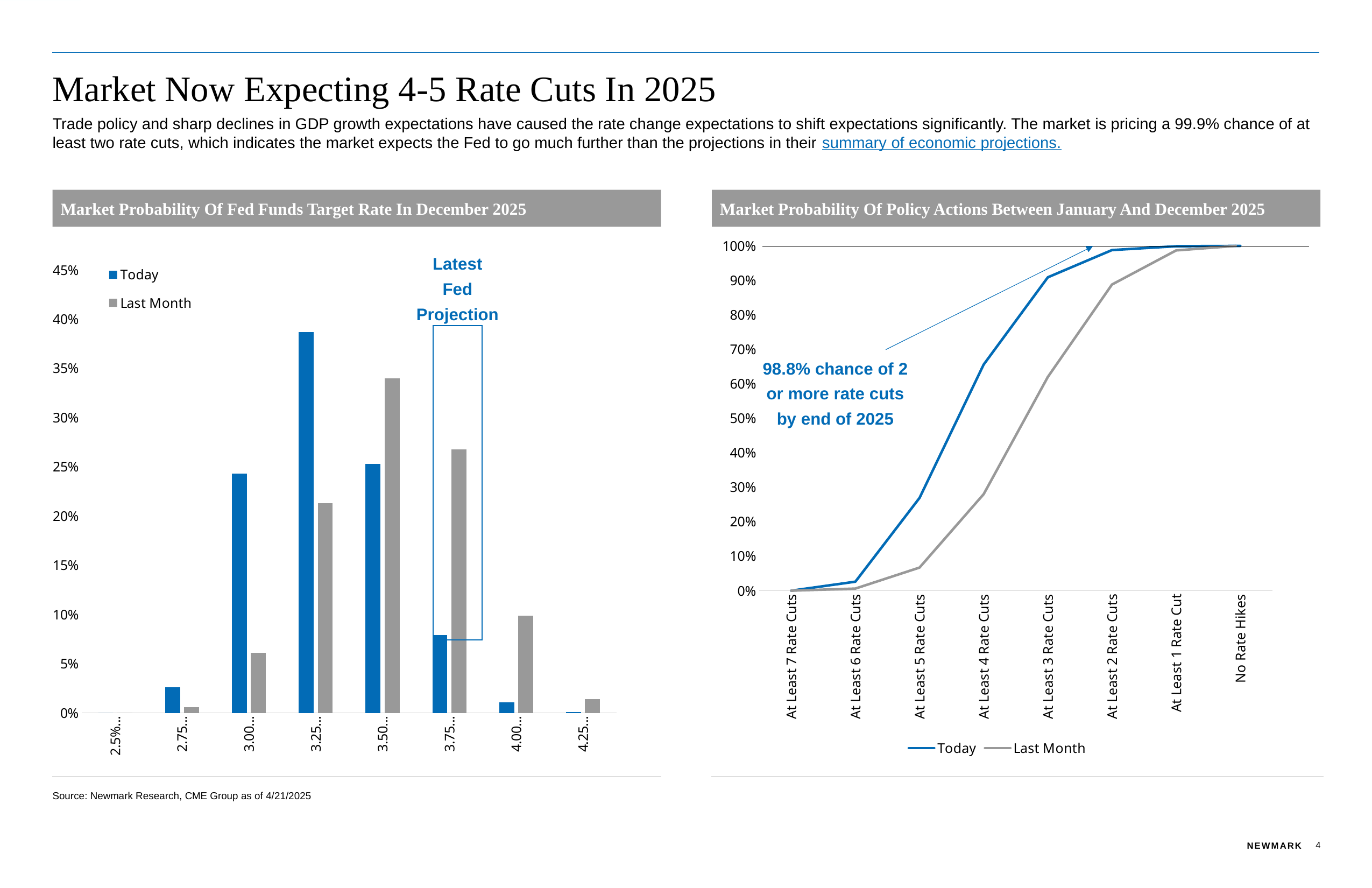
In the 'Market Probability Of Policy Actions Between January And December 2025' chart, do the Today values rise or fall moving from 'At Least 7 Rate Cuts' to 'No Rate Hikes'? rise In the 'Market Probability Of Policy Actions Between January And December 2025' chart, what chance of 2 or more rate cuts by end of 2025 does the annotation state? 98.8% What kind of chart is the 'Market Probability Of Policy Actions Between January And December 2025' chart? line chart In the 'Market Probability Of Fed Funds Target Rate In December 2025' chart, how many series does the legend list? 2 In the 'Market Probability Of Fed Funds Target Rate In December 2025' chart, which category has the highest Today value? 3.25... In the 'Market Probability Of Policy Actions Between January And December 2025' chart, is the Today value for 'At Least 3 Rate Cuts' greater or less than 80%? greater What kind of chart is the 'Market Probability Of Fed Funds Target Rate In December 2025' chart? bar chart In the 'Market Probability Of Fed Funds Target Rate In December 2025' chart, which category has the highest Last Month value? 3.50... In the 'Market Probability Of Fed Funds Target Rate In December 2025' chart, is the Last Month value for the 3.00... category greater or less than 10%? less In the 'Market Probability Of Fed Funds Target Rate In December 2025' chart, is the Today value for the 3.25... category greater or less than 35%? greater In the 'Market Probability Of Policy Actions Between January And December 2025' chart, how many categories are shown on the x axis? 8 In the 'Market Probability Of Fed Funds Target Rate In December 2025' chart, which is larger for the 3.75... category, Today or Last Month? Last Month